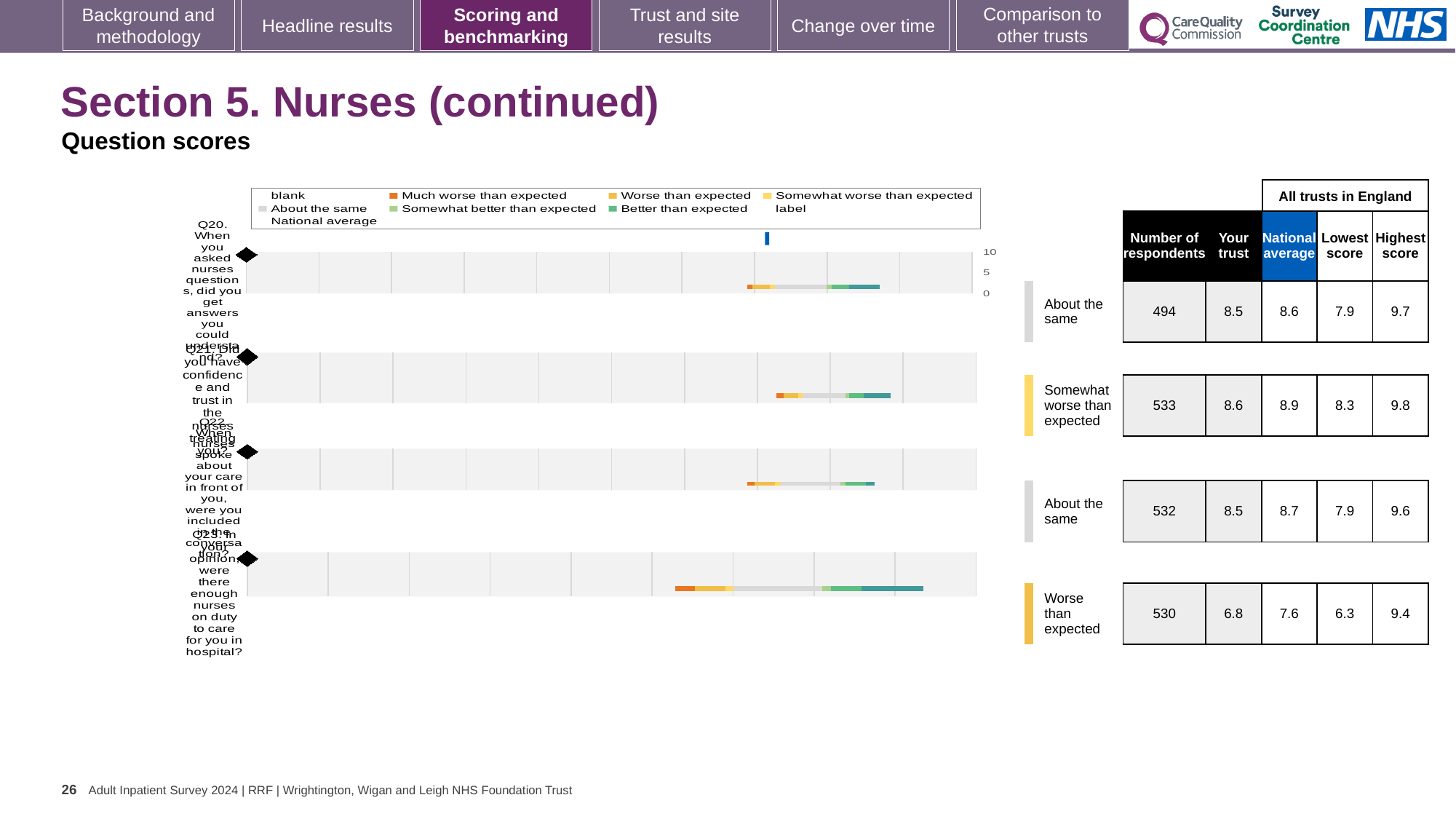
What kind of chart is shown on the slide? bar chart What is the difference between the national average and the 'Your trust' score for Q23? 0.8 What benchmark rating is given for Q23? Worse than expected How many questions (bars) are plotted in the chart? 4 Which is larger, the 'Your trust' score for Q21 or for Q22? Q21 What colour does the legend use for 'Much worse than expected'? orange Which question has the lowest 'Your trust' score? Q23 How many respondents answered Q20? 494 What is the highest value shown on the chart's score axis? 10 What is the 'Your trust' score for Q23 (were there enough nurses on duty)? 6.8 What is the national average score for Q21 (confidence and trust in nurses)? 8.9 Which question has the highest number of respondents? Q21